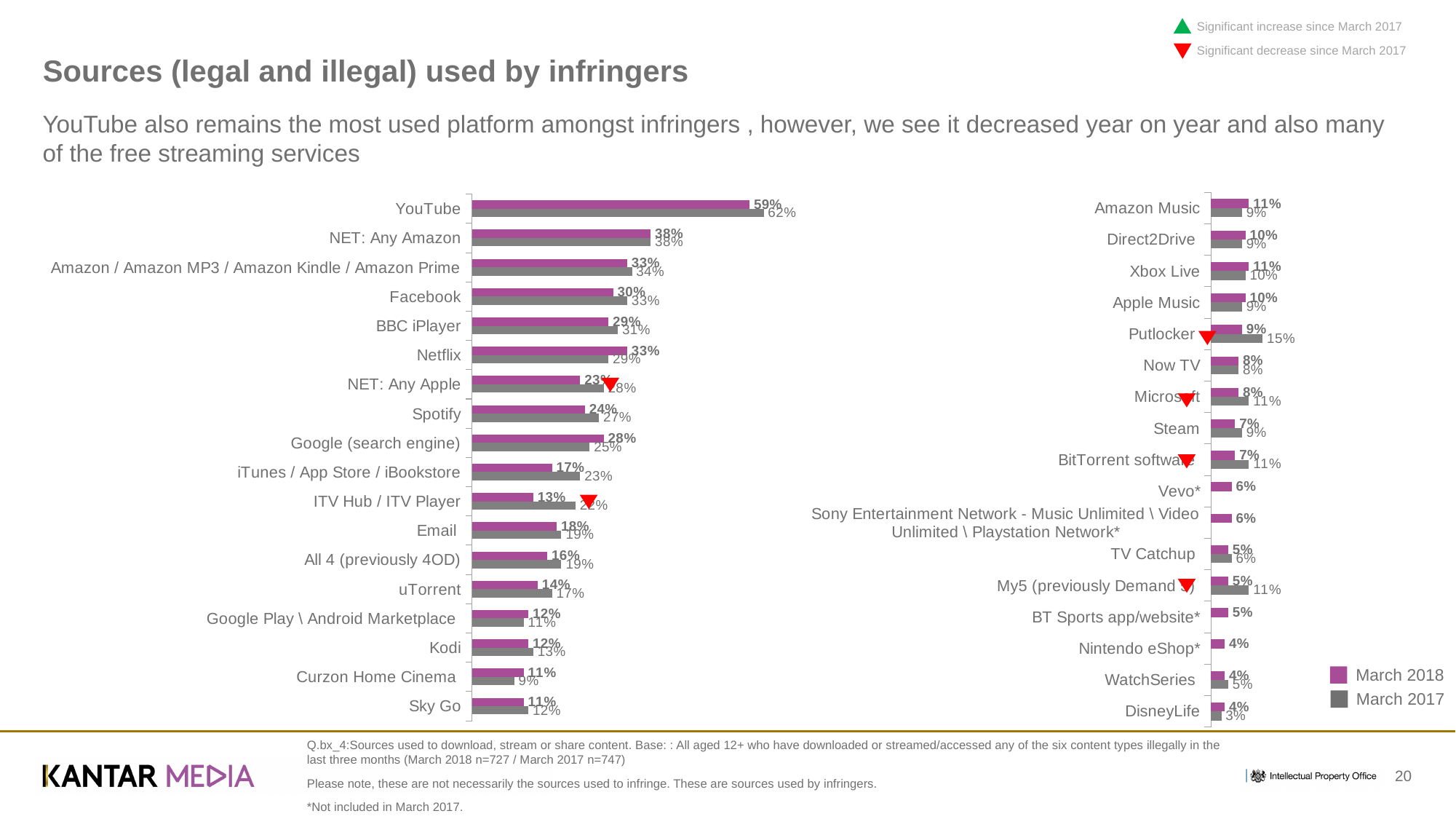
In the right chart, which source has the lowest March 2017 value? DisneyLife How many series does the legend list? 2 In the left chart, what is the difference between the March 2017 and March 2018 values for iTunes / App Store / iBookstore? 6% In the left chart, which is larger for Netflix: the March 2018 value or the March 2017 value? March 2018 In the right chart, what is the March 2017 value for Putlocker? 15% In the left chart, what is the March 2017 value for Facebook? 33% What type of chart is used on this slide? Bar chart In the right chart, what is the difference between the March 2017 and March 2018 values for My5 (previously Demand 5)? 6% Which colour represents March 2018 in the legend? Purple In the left chart, what is the March 2018 value for YouTube? 59% In the left chart, which source has the highest March 2018 value? YouTube How many sources are listed in the left chart? 18